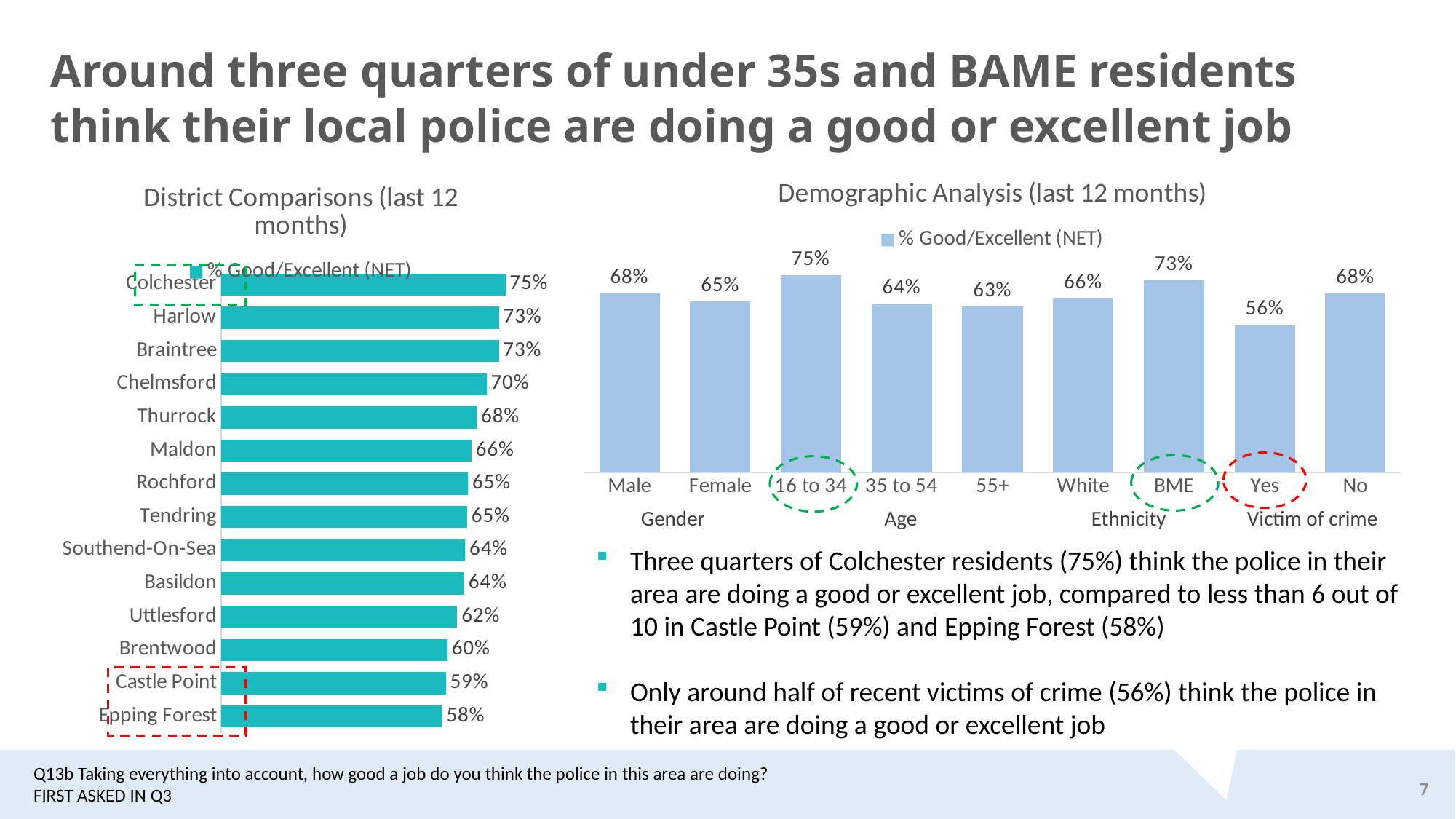
What type of chart is the Demographic Analysis chart? Bar chart How many series does the legend of the District Comparisons chart list? 1 In the Demographic Analysis chart, which category has the lowest value? Yes In the Demographic Analysis chart, how many categories are plotted? 9 In the District Comparisons chart, what is the difference between the values for Colchester and Castle Point? 16% In the District Comparisons chart, which has the larger value, Thurrock or Uttlesford? Thurrock In the District Comparisons chart, how many districts are shown? 14 In the Demographic Analysis chart, what is the value for 16 to 34? 75% In the District Comparisons chart, which district has the lowest % Good/Excellent (NET) value? Epping Forest In the District Comparisons chart, what is the % Good/Excellent (NET) value for Chelmsford? 70% In the District Comparisons chart, which district has the highest % Good/Excellent (NET) value? Colchester In the Demographic Analysis chart, what is the difference between the values for BME and White? 7%